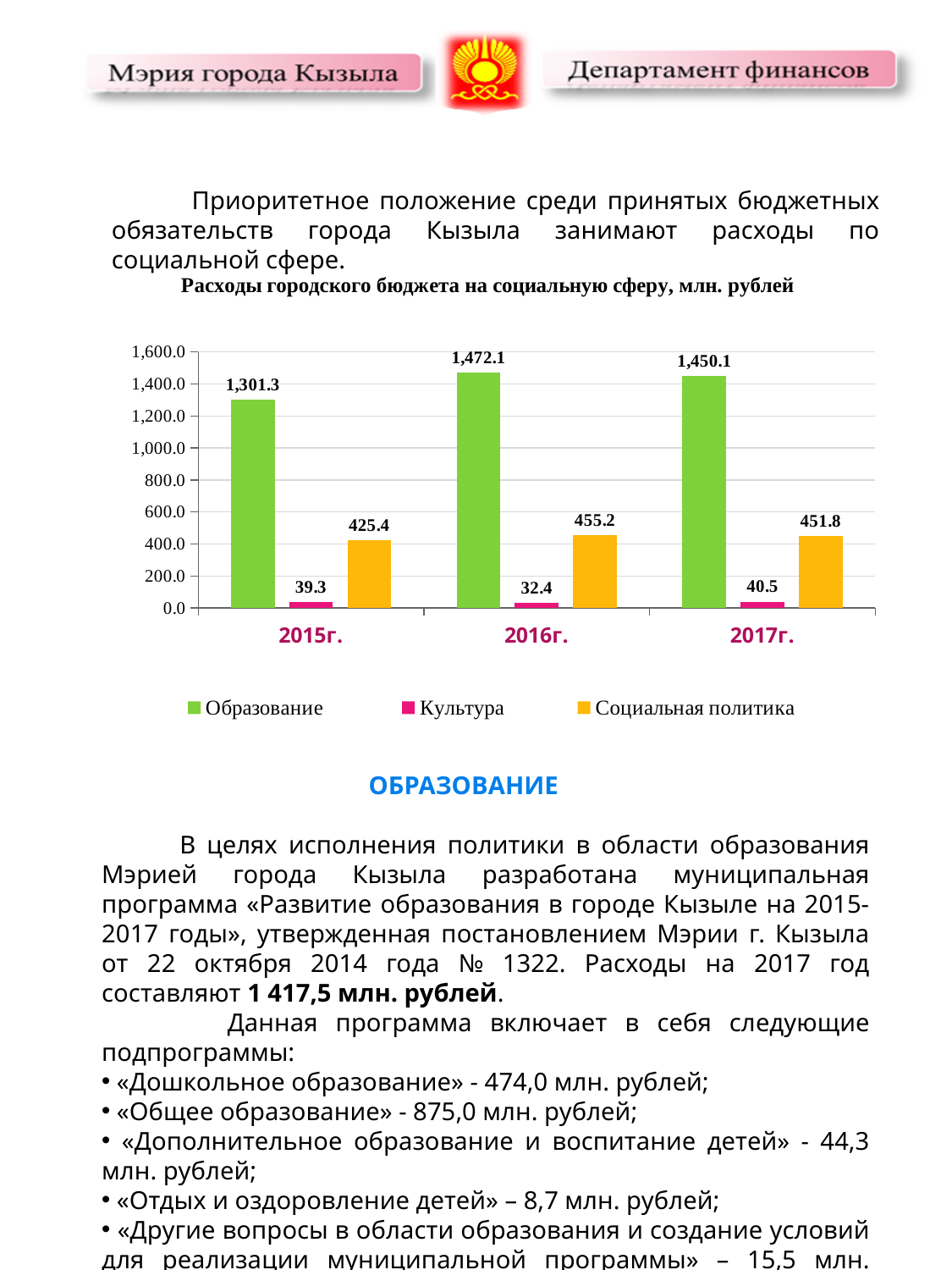
What is the title of the chart? Расходы городского бюджета на социальную сферу, млн. рублей How many series does the legend list? 3 What is the difference between the Образование values for 2016г. and 2015г.? 170.8 Which is larger: Социальная политика in 2016г. or in 2015г.? 2016г. What is the value for Культура in 2017г.? 40.5 In which year is the value for Культура lowest? 2016г. In which year is the value for Образование highest? 2016г. What kind of chart is shown? bar chart What is the value for Образование in 2016г.? 1,472.1 Is the value for Образование in 2017г. greater or less than 1,400.0? greater What is the value for Социальная политика in 2015г.? 425.4 How many years are shown on the x axis? 3